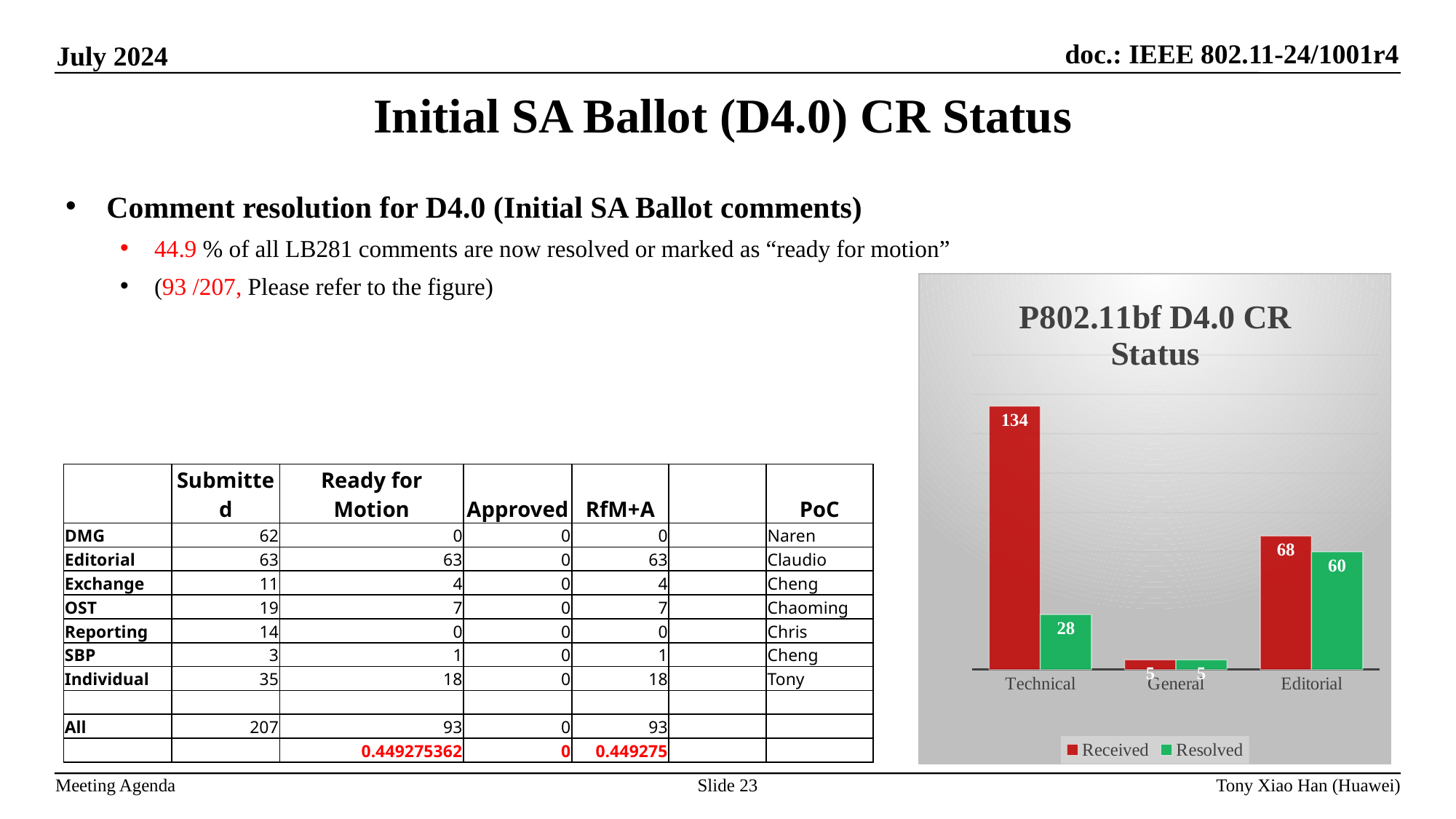
What is the Received value for Technical? 134 What is the Resolved value for Technical? 28 What is the difference between Received and Resolved for Technical? 106 How many categories are shown on the x axis? 3 Which category has the highest Received value? Technical What type of chart is shown? bar chart Is the Received value for Editorial larger than the Resolved value for Editorial? Yes How many series does the legend list? 2 Which category has the lowest Resolved value? General What is the title of the chart? P802.11bf D4.0 CR Status What is the Resolved value for General? 5 What is the Received value for Editorial? 68